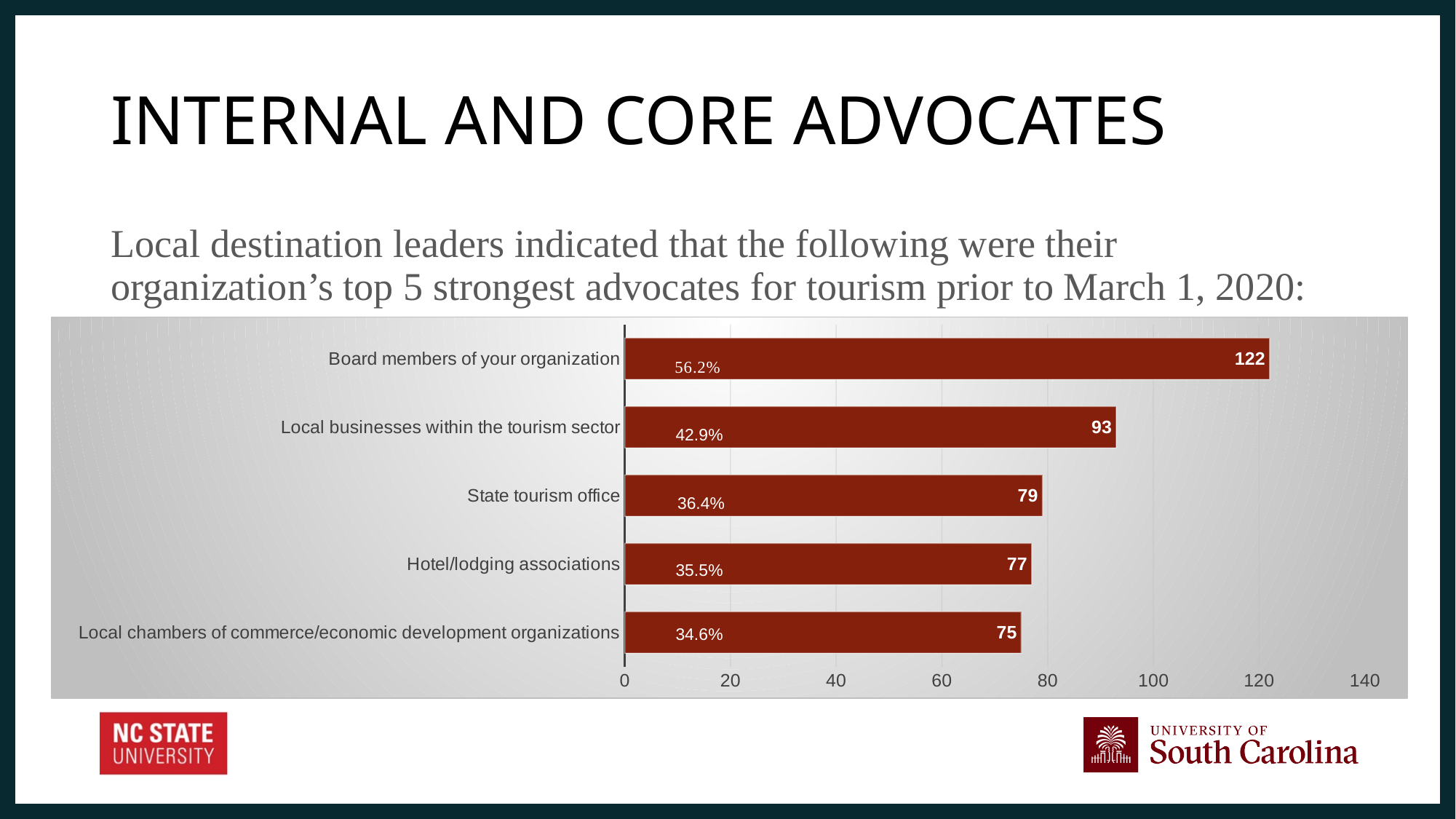
What percentage is shown for Local businesses within the tourism sector? 42.9% What is the value for Board members of your organization? 122 Which is larger, the value for State tourism office or the value for Hotel/lodging associations? State tourism office Which category has the highest value? Board members of your organization What is the value for State tourism office? 79 What kind of chart is shown on the slide? bar chart How many categories are shown in the chart? 5 What is the maximum value shown on the horizontal axis? 140 What percentage is shown for Local chambers of commerce/economic development organizations? 34.6% Is the value for Local businesses within the tourism sector greater or less than 100? less What is the difference between the values for Board members of your organization and Local businesses within the tourism sector? 29 Which category has the lowest value? Local chambers of commerce/economic development organizations